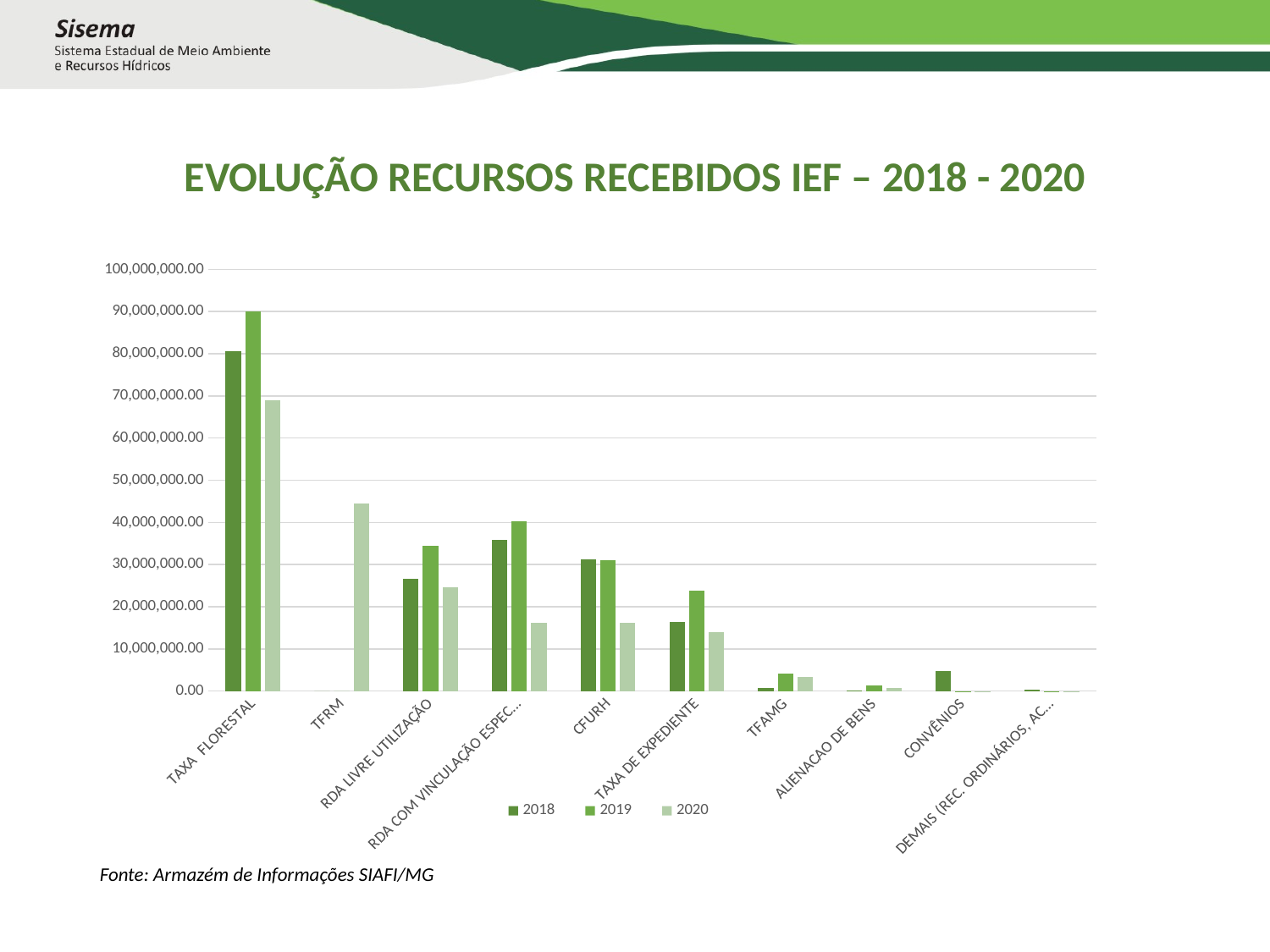
What kind of chart is shown on the slide? Bar chart What is the title of the chart? EVOLUÇÃO RECURSOS RECEBIDOS IEF – 2018 - 2020 Which category has the highest value for 2020? TAXA FLORESTAL Is the 2019 value for TAXA FLORESTAL greater or less than 80,000,000.00? greater For RDA LIVRE UTILIZAÇÃO, which year has the larger value, 2018 or 2019? 2019 For TAXA DE EXPEDIENTE, which year has the larger value, 2019 or 2020? 2019 How many series does the legend list? 3 Is the 2020 value for CFURH greater or less than 20,000,000.00? less Which category has the highest value for 2019? TAXA FLORESTAL Moving from left to right along the x axis, do the 2019 values generally rise or fall? Fall How many categories are shown on the x axis? 10 Is the 2020 value for TFRM greater or less than 40,000,000.00? greater